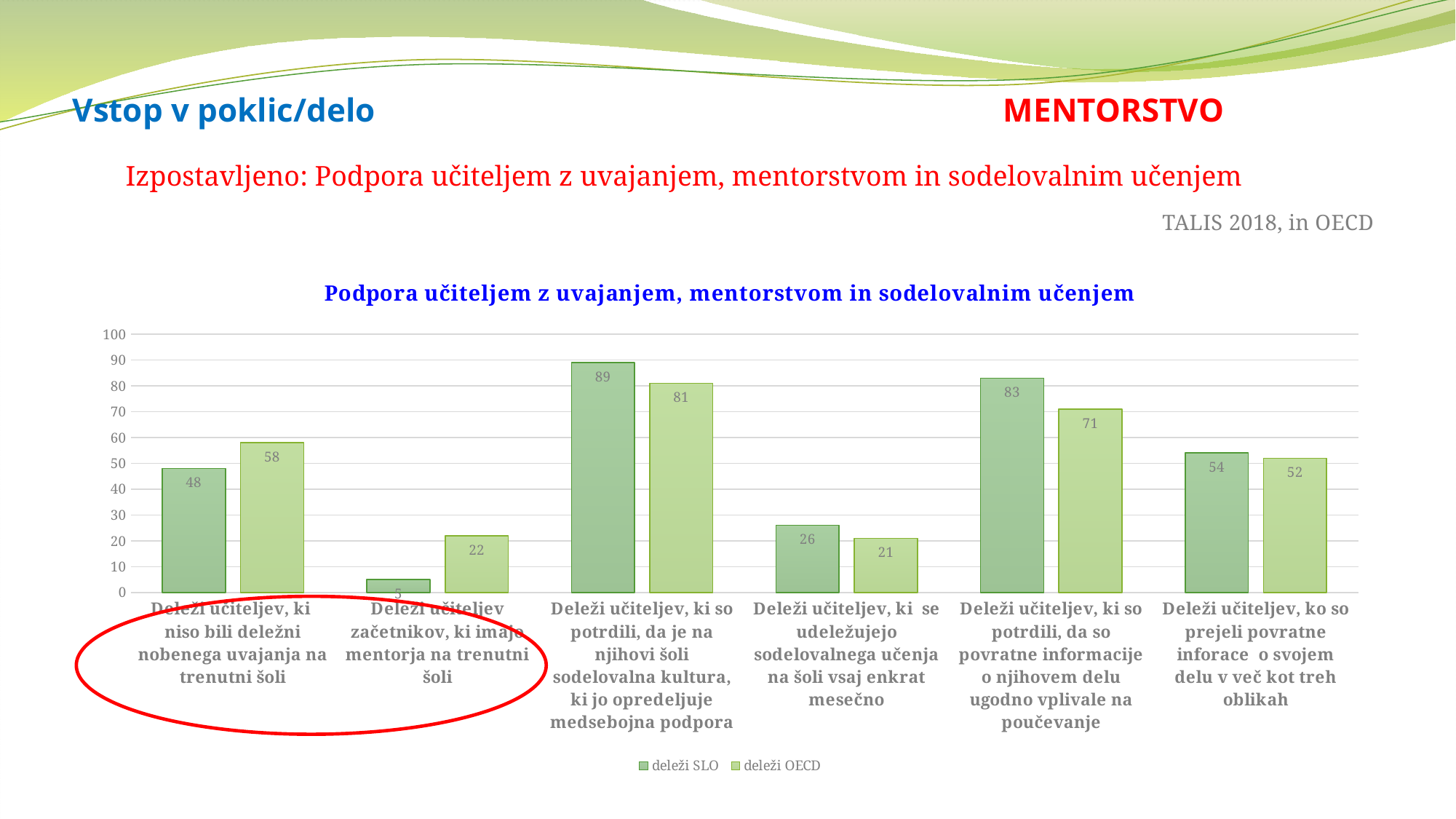
What is the title of the chart? Podpora učiteljem z uvajanjem, mentorstvom in sodelovalnim učenjem Which category has the highest 'deleži SLO' value? Deleži učiteljev, ki so potrdili, da je na njihovi šoli sodelovalna kultura, ki jo opredeljuje medsebojna podpora What is the difference between 'deleži OECD' and 'deleži SLO' for 'Deleži učiteljev začetnikov, ki imajo mentorja na trenutni šoli'? 17 What is the value of 'deleži OECD' for 'Deleži učiteljev, ki niso bili deležni nobenega uvajanja na trenutni šoli'? 58 Which is larger for 'Deleži učiteljev, ki so potrdili, da je na njihovi šoli sodelovalna kultura, ki jo opredeljuje medsebojna podpora': 'deleži SLO' or 'deleži OECD'? deleži SLO What is the difference between 'deleži SLO' and 'deleži OECD' for 'Deleži učiteljev, ki so potrdili, da so povratne informacije o njihovem delu ugodno vplivale na poučevanje'? 12 What is the value of 'deleži SLO' for 'Deleži učiteljev, ki so potrdili, da so povratne informacije o njihovem delu ugodno vplivale na poučevanje'? 83 What is the value of 'deleži SLO' for 'Deleži učiteljev začetnikov, ki imajo mentorja na trenutni šoli'? 5 Which category has the lowest 'deleži OECD' value? Deleži učiteljev, ki se udeležujejo sodelovalnega učenja na šoli vsaj enkrat mesečno How many series does the legend list? 2 What type of chart is shown on the slide? bar chart How many categories are shown on the x axis? 6